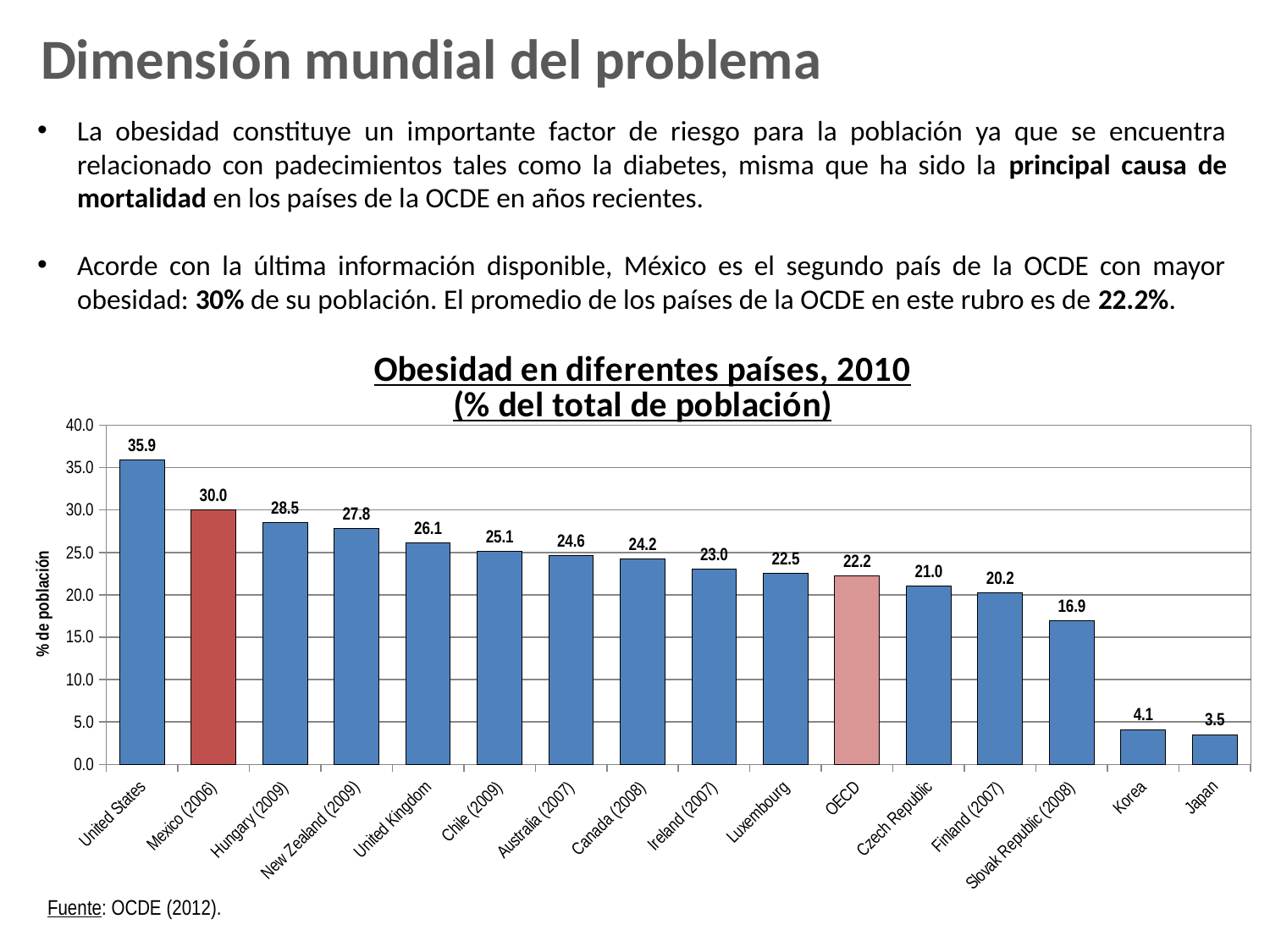
Which has a higher value, Hungary (2009) or New Zealand (2009)? Hungary (2009) What is the difference between the values for United States and Mexico (2006)? 5.9 Is the value for Slovak Republic (2008) greater or less than 20.0? less What is the value shown for the OECD bar? 22.2 Do the values rise or fall from left to right along the x axis? fall What is the value shown for Korea? 4.1 Which country has the lowest obesity value in the chart? Japan How many bars are plotted in the chart? 16 What kind of chart is shown on the slide? bar chart What is the title of the chart? Obesidad en diferentes países, 2010 (% del total de población) What is the obesity value shown for Mexico (2006)? 30.0 Which country has the highest obesity value in the chart? United States